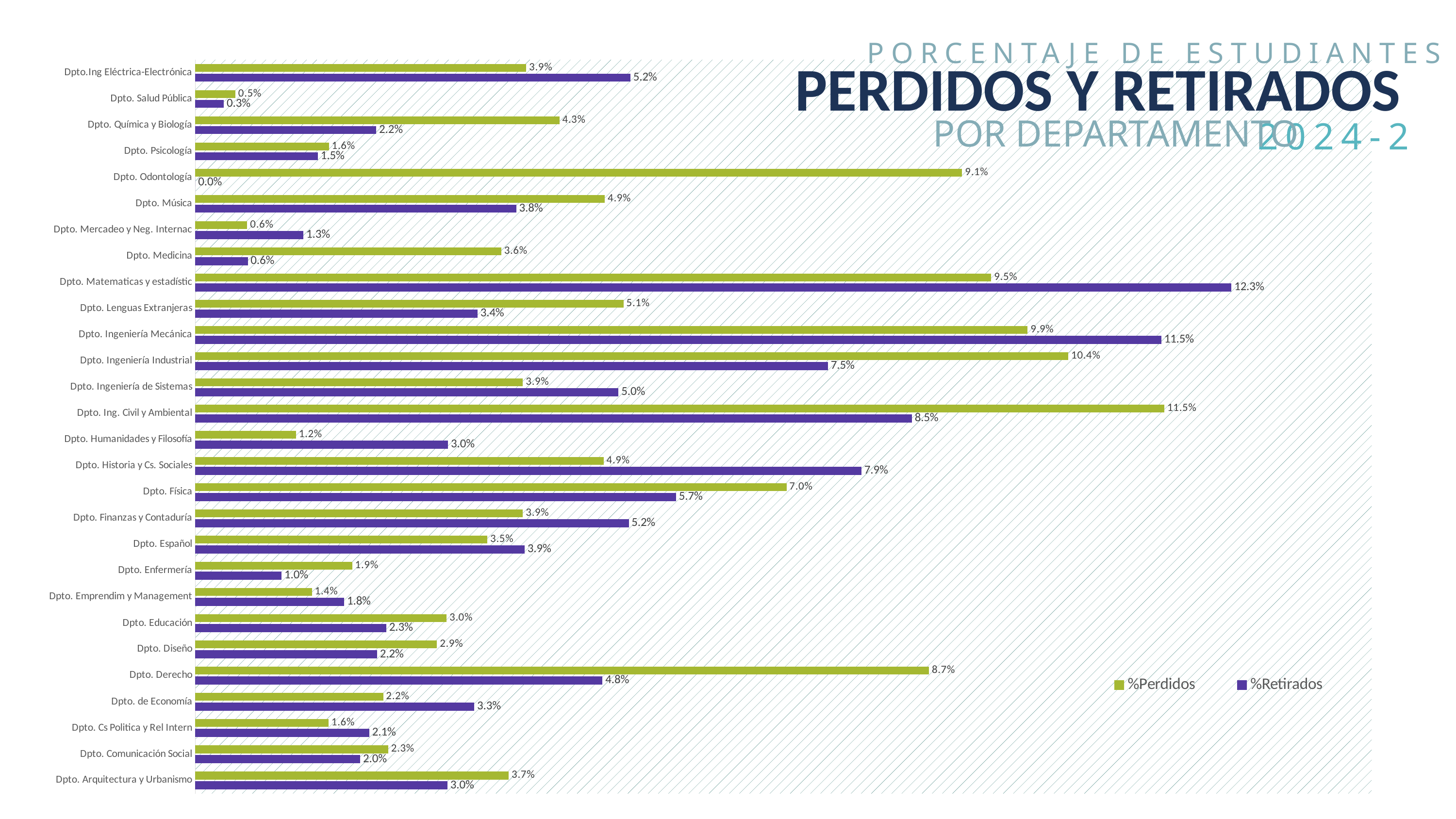
Which department has the highest %Perdidos value? Dpto. Ing. Civil y Ambiental Which department has the lowest %Retirados value? Dpto. Odontología How many departments are shown in the chart? 28 What kind of chart is shown on the slide? Bar chart For Dpto. Historia y Cs. Sociales, which is larger: %Perdidos or %Retirados? %Retirados Which department has the lowest %Perdidos value? Dpto. Salud Pública What is the %Perdidos value for Dpto. Odontología? 9.1% What is the difference between %Perdidos and %Retirados for Dpto. Ingeniería Industrial? 2.9% Which department has the highest %Retirados value? Dpto. Matematicas y estadístic How many series does the legend list? 2 What is the %Perdidos value for Dpto. Derecho? 8.7% What is the %Retirados value for Dpto. Matematicas y estadístic? 12.3%